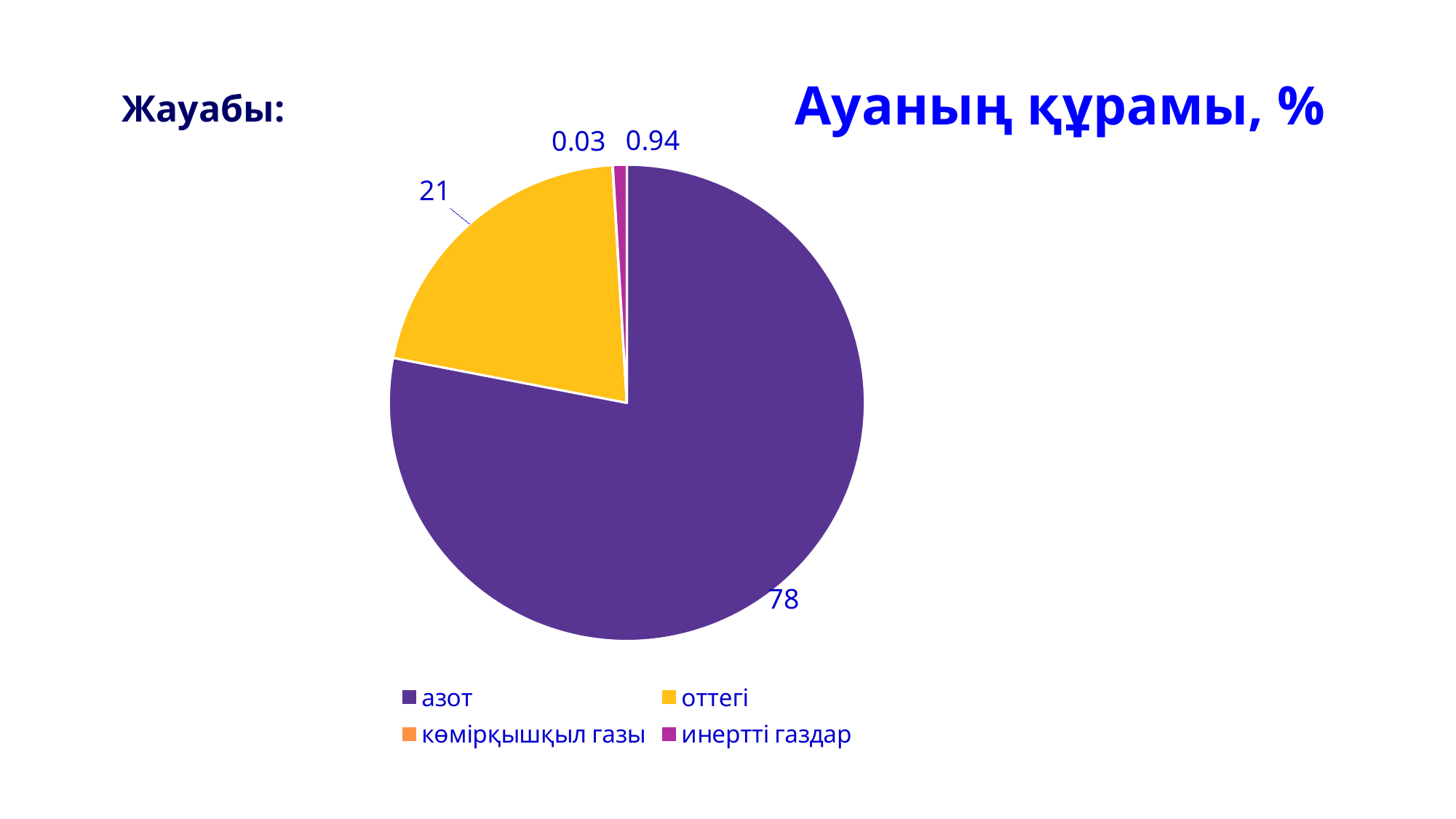
What is the value for азот in the pie chart? 78 What is the value for инертті газдар in the pie chart? 0.94 What is the title of the chart? Ауаның құрамы, % What colour is the slice for оттегі? yellow Which category has the largest slice of the pie? азот What is the value for көмірқышқыл газы in the pie chart? 0.03 What is the value for оттегі in the pie chart? 21 How many categories does the pie chart show? 4 What kind of chart is shown on the slide? pie chart Which is larger, the value for инертті газдар or the value for көмірқышқыл газы? инертті газдар What is the difference between the values for азот and оттегі? 57 Which category has the smallest slice of the pie? көмірқышқыл газы